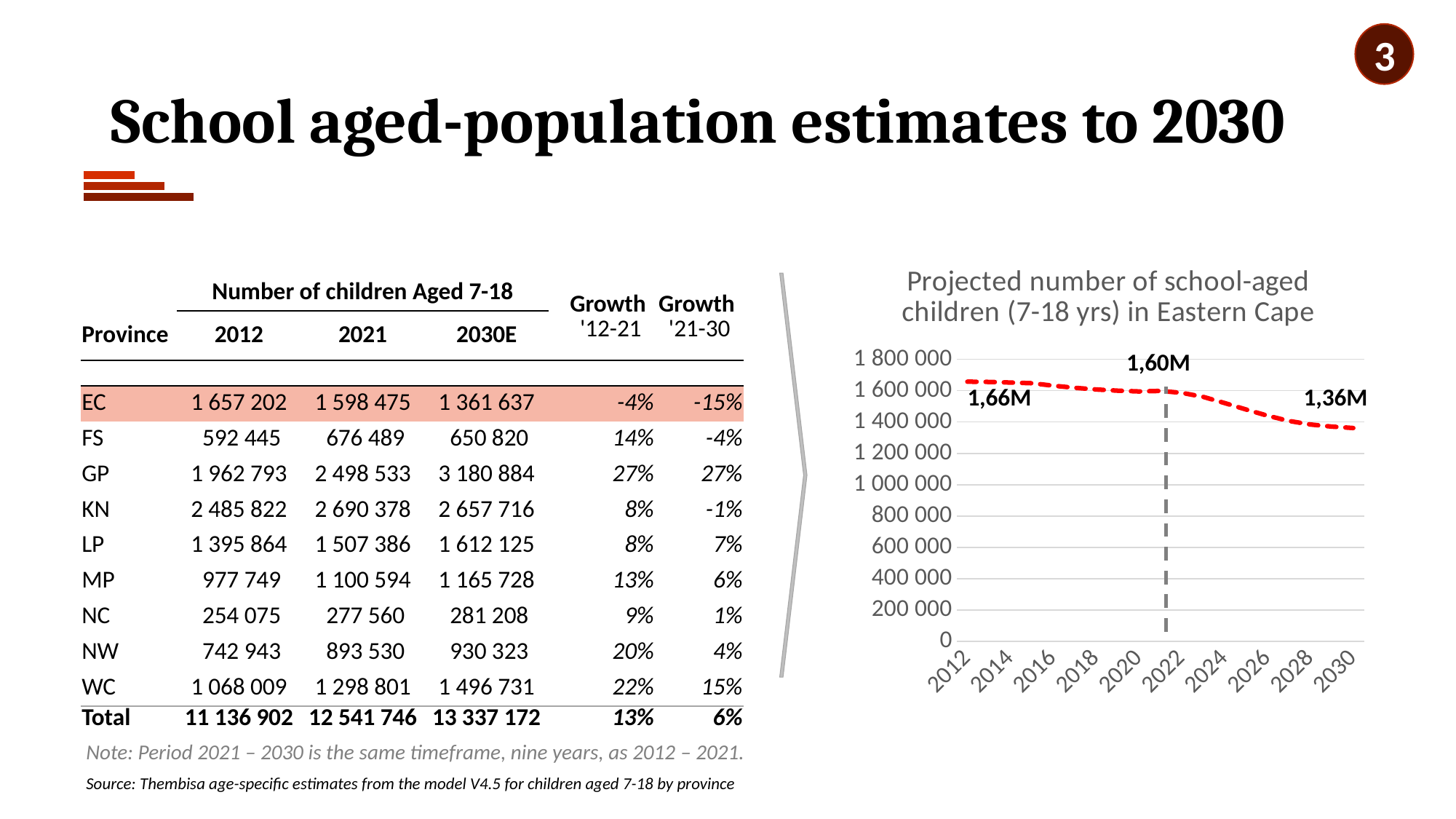
What kind of chart is shown on the right of the slide? line chart In the Eastern Cape chart, what value is labelled at the start of the line in 2012? 1,66M In the Eastern Cape chart, what value is labelled at the end of the line in 2030? 1,36M What is the title of the chart on the right of the slide? Projected number of school-aged children (7-18 yrs) in Eastern Cape In the Eastern Cape chart, which labelled point is the highest: 2012, 2021 or 2030? 2012 In the Eastern Cape chart, which labelled point is the lowest: 2012, 2021 or 2030? 2030 In the Eastern Cape chart, which is larger, the labelled value for 2021 or for 2030? 2021 In the Eastern Cape chart, is the value in 2030 greater or less than 1 400 000? less In the Eastern Cape chart, is the value in 2012 greater or less than 1 600 000? greater In the Eastern Cape chart, what value is labelled at the dashed vertical line around 2021? 1,60M In the Eastern Cape chart, does the projected number of school-aged children rise or fall from 2012 to 2030? fall In the Eastern Cape chart, what is the highest value shown on the vertical axis? 1 800 000